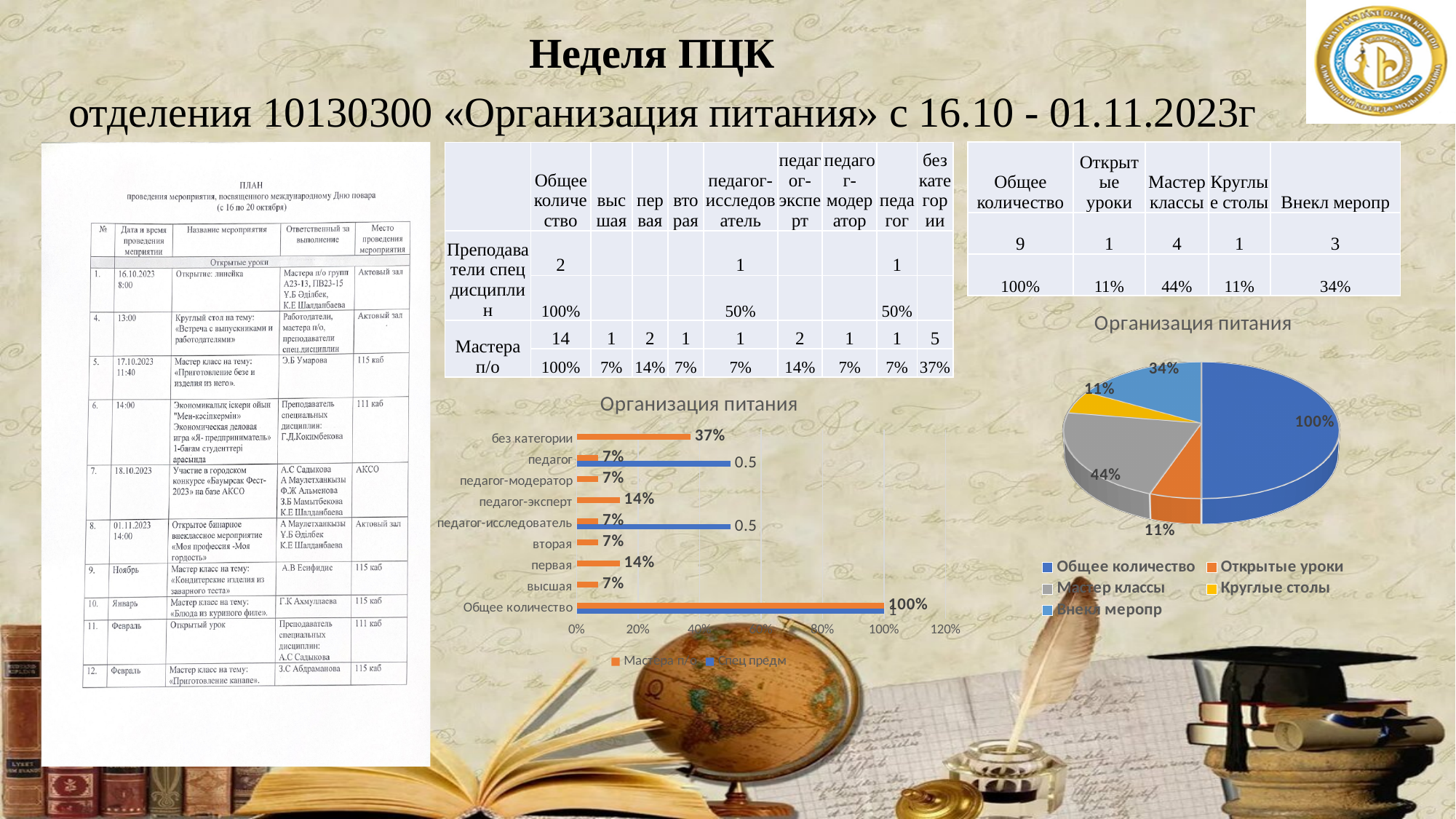
In the bar chart, what is the value of 'Мастера п/о' for 'без категории'? 37% What kind of chart is the chart on the right of the slide titled 'Организация питания'? pie chart In the bar chart, what is the value of 'Мастера п/о' for 'педагог-эксперт'? 14% In the bar chart, what is the difference between the 'Мастера п/о' values for 'первая' and 'высшая'? 7% In the pie chart, which is larger: 'Внекл меропр' or 'Открытые уроки'? Внекл меропр In the bar chart, what is the value of 'Спец предм' for 'педагог-исследователь'? 0.5 What kind of chart is the chart in the middle of the slide titled 'Организация питания'? bar chart In the bar chart, how many series does the legend list? 2 In the pie chart, how many entries does the legend list? 5 In the bar chart, which category other than 'Общее количество' has the highest 'Мастера п/о' value? без категории In the bar chart, how many categories are shown on the vertical axis? 9 In the pie chart, what is the share of 'Мастер классы'? 44%